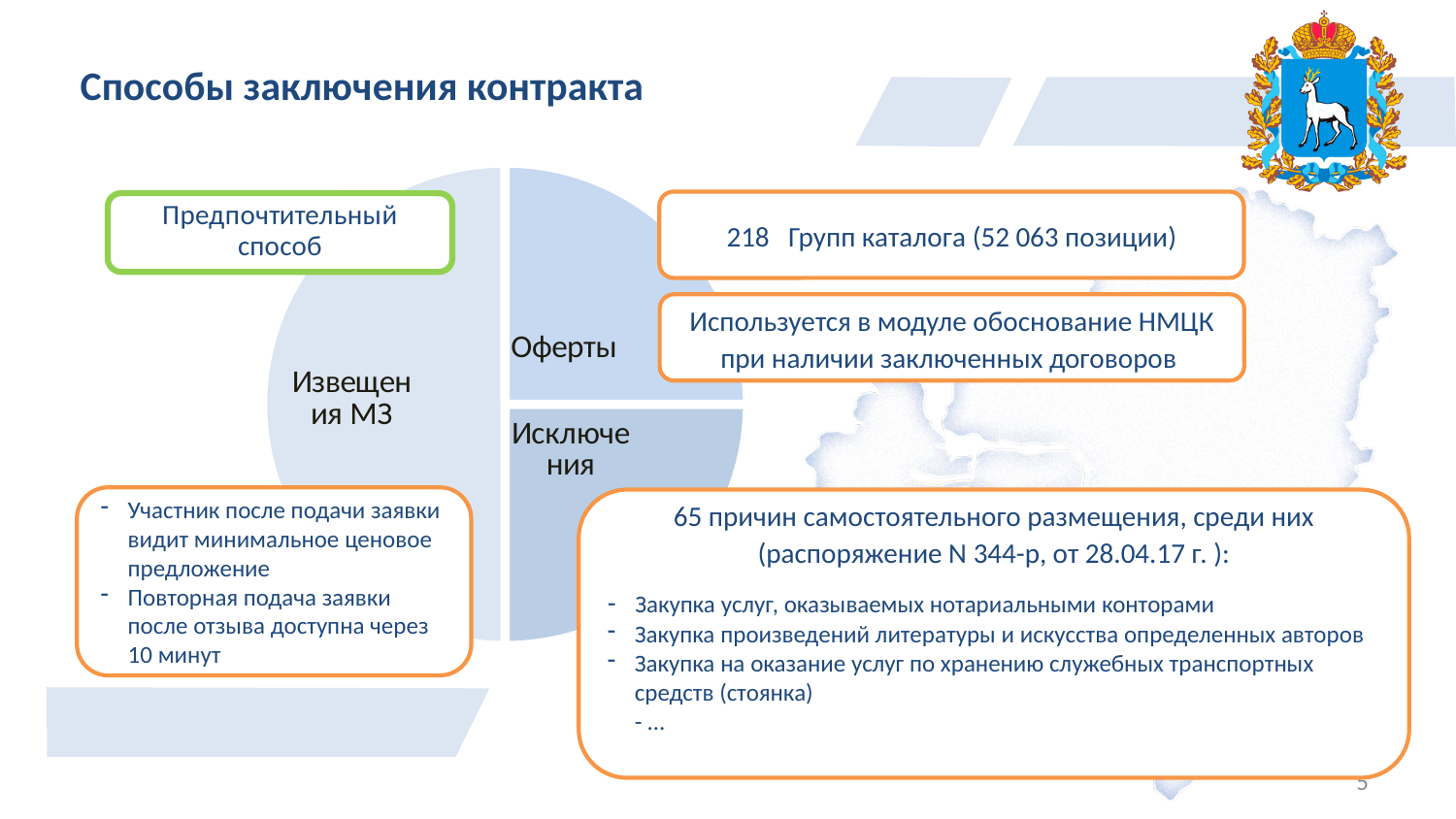
Which segment of the pie chart is the largest? Извещения МЗ What kind of chart is shown on the slide? pie chart Which segment is larger in the pie chart, Извещения МЗ or Исключения? Извещения МЗ What is the title of the slide containing the pie chart? Способы заключения контракта What are the labels of the three segments of the pie chart? Извещения МЗ, Оферты, Исключения How many segments does the pie chart have? 3 Which segment is larger in the pie chart, Извещения МЗ or Оферты? Извещения МЗ